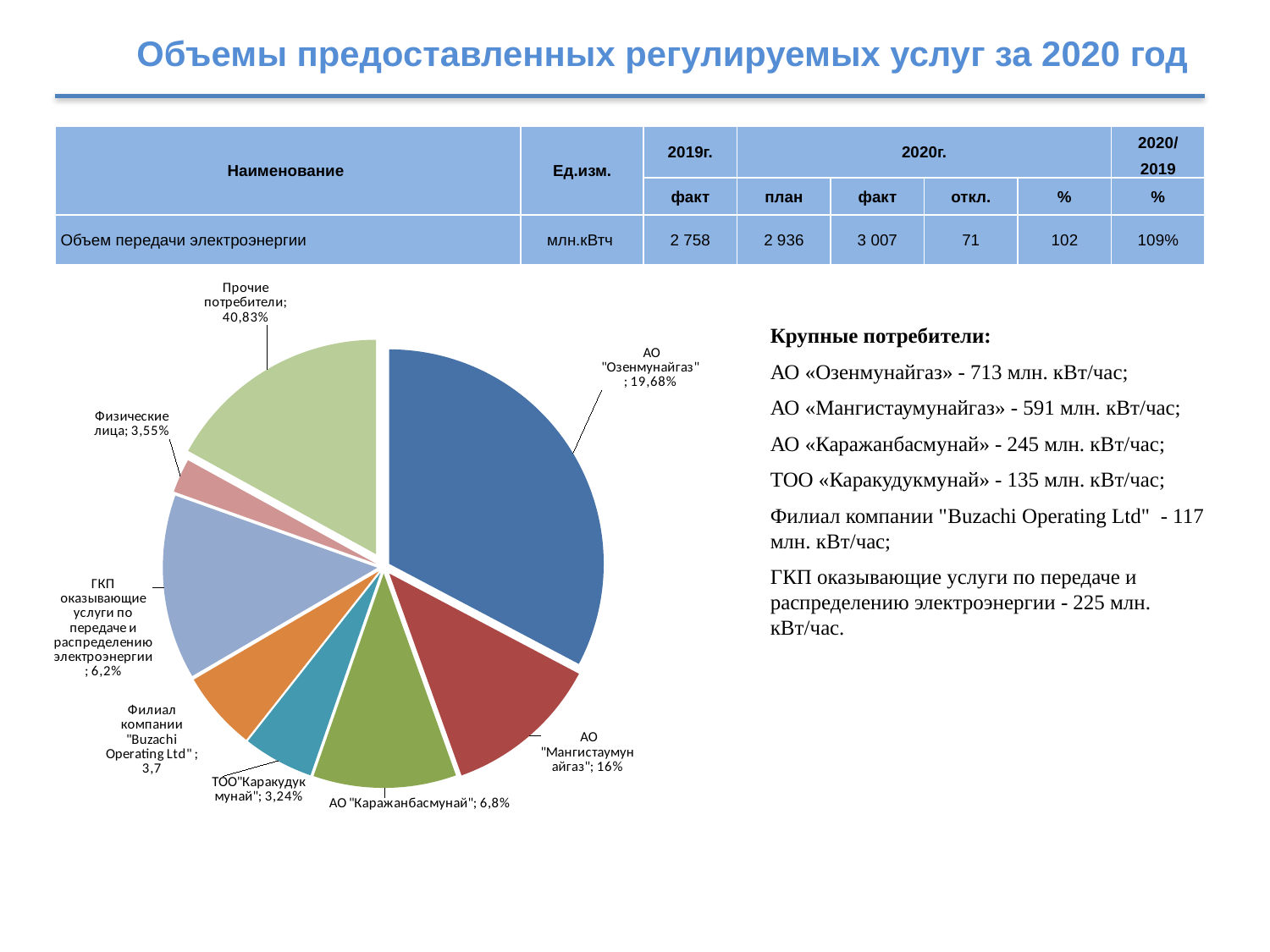
What share of the pie is labelled for Физические лица? 3,55% Which slice is larger: АО "Озенмунайгаз" or АО "Мангистаумунайгаз"? АО "Озенмунайгаз" What is the difference in percentage points between the Прочие потребители slice and the АО "Озенмунайгаз" slice? 21,15 What kind of chart is shown on the slide? pie chart How many slices does the pie chart have? 8 What share of the pie is labelled for Прочие потребители? 40,83% What share of the pie is labelled for АО "Каражанбасмунай"? 6,8% What share of the pie is labelled for АО "Мангистаумунайгаз"? 16% What share of the pie is labelled for ТОО "Каракудукмунай"? 3,24% What share of the pie is labelled for АО "Озенмунайгаз"? 19,68%